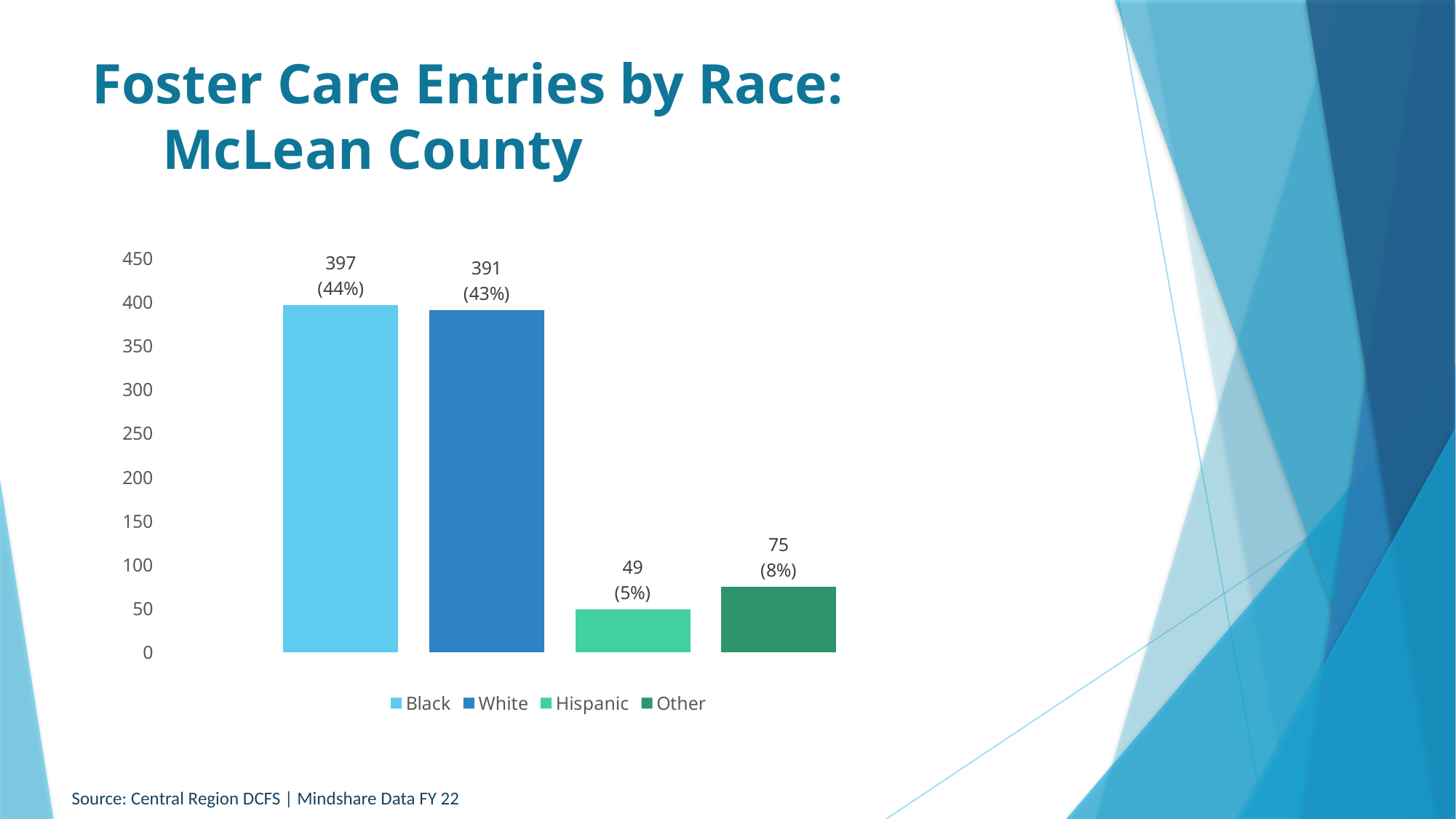
Which has more foster care entries, Other or Hispanic? Other What percentage of foster care entries is labelled for Other? 8% How many foster care entries are shown for Hispanic? 49 What is the difference in foster care entries between Other and Hispanic? 26 Is the value for White greater or less than 350? greater How many foster care entries are shown for Black in McLean County? 397 What kind of chart is shown on the slide? Bar chart Which category has the lowest number of foster care entries? Hispanic What is the source cited at the bottom of the slide? Central Region DCFS | Mindshare Data FY 22 What is the difference in foster care entries between Black and White? 6 How many foster care entries are shown for White? 391 How many categories are shown in the chart? 4